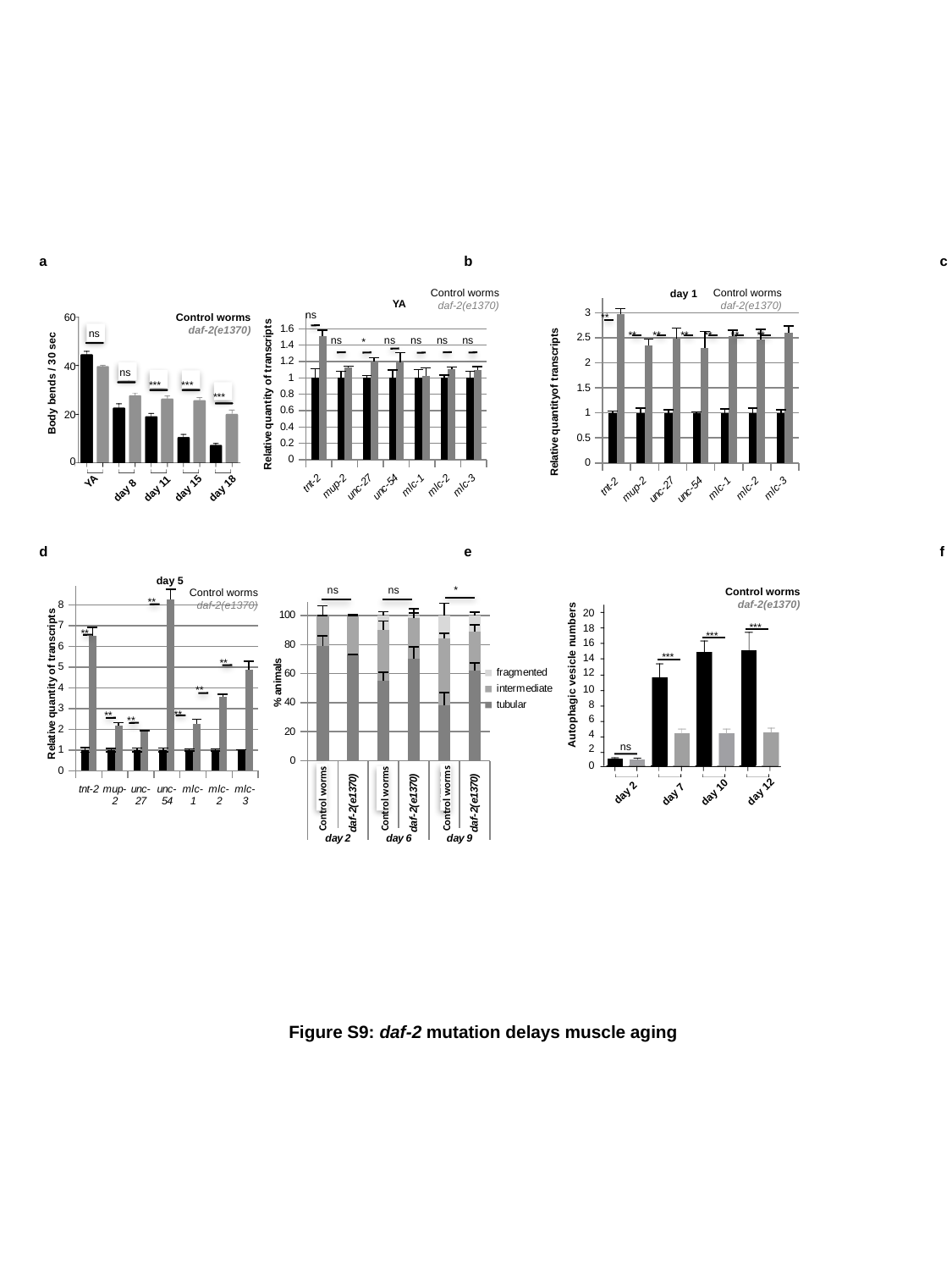
In panel d (day 5), is the daf-2(e1370) value for tnt-2 greater or less than 6? greater In panel f (Autophagic vesicle numbers), which is larger at day 7: Control worms or daf-2(e1370)? Control worms In panel a (Body bends / 30 sec), is the value for Control worms at day 18 greater or less than 20? less In panel b (YA, relative quantity of transcripts), for which gene is the daf-2(e1370) bar highest? tnt-2 In panel a (Body bends / 30 sec), how many time-point categories are shown on the x axis? 5 In panel a (Body bends / 30 sec), is the value for Control worms at YA greater or less than 40? greater In panel e (% animals), how many series does the legend list? 3 In panel a (Body bends / 30 sec), do the Control worms values rise or fall from YA to day 18? fall In panel d (day 5), for which gene is the daf-2(e1370) bar highest? unc-54 In panel c (day 1), for which gene is the daf-2(e1370) bar highest? tnt-2 In panel b (YA, relative quantity of transcripts), how many genes are shown on the x axis? 7